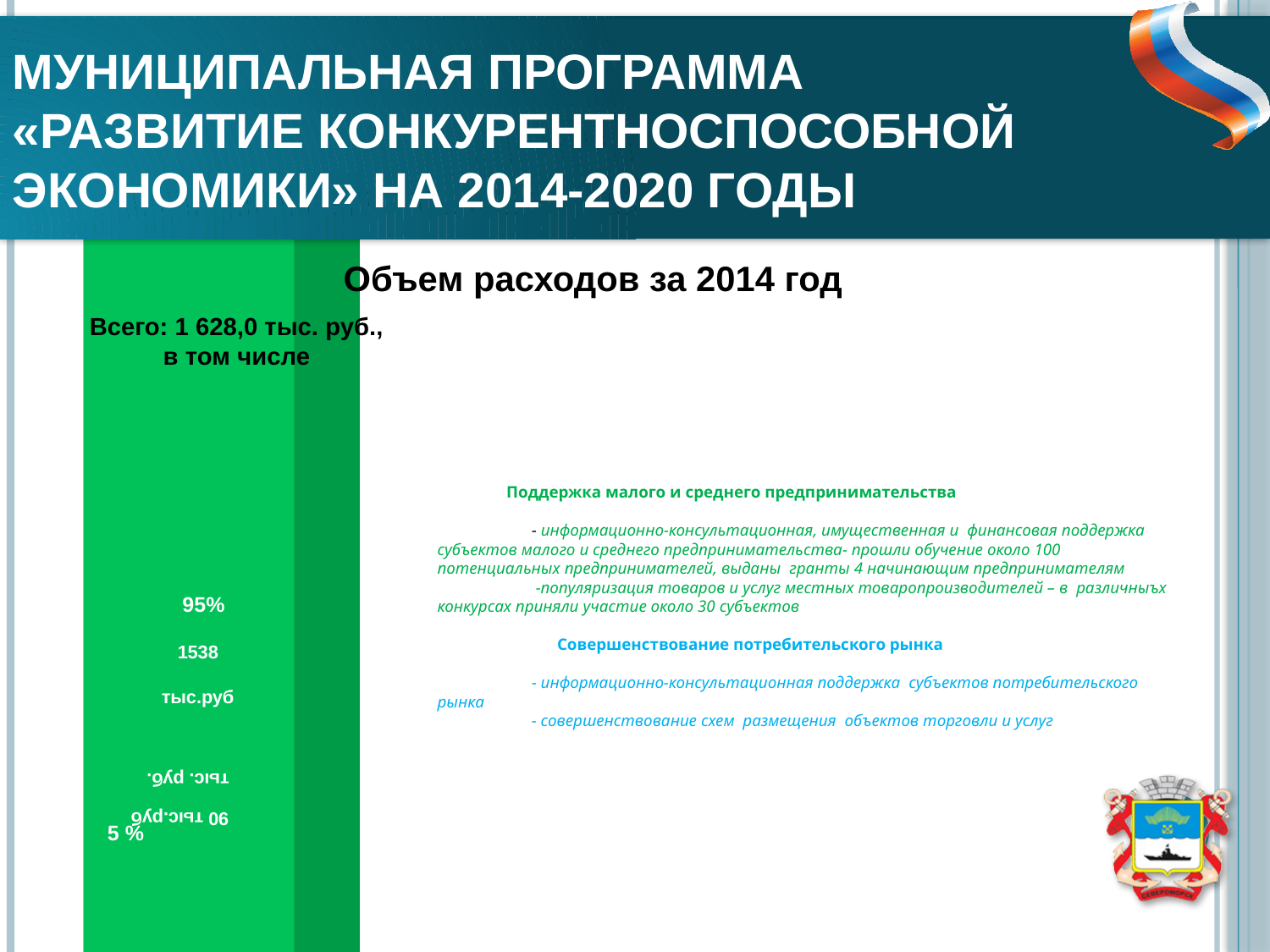
How many percentage shares are printed on the chart? 2 What is the difference between the 1538 тыс.руб value and the 90 тыс.руб value on the chart? 1448 тыс.руб What amount in тыс.руб is printed next to the 95% label on the chart? 1538 тыс.руб What is the smaller percentage share printed on the chart? 5 % What amount in тыс.руб is printed next to the 5 % label on the chart? 90 тыс.руб What is the title of the chart section on the slide? Объем расходов за 2014 год Which is larger on the chart: the 1538 тыс.руб value or the 90 тыс.руб value? 1538 тыс.руб What is the larger percentage share printed on the chart? 95% What is the total expenditure for 2014 stated above the chart? 1 628,0 тыс. руб.